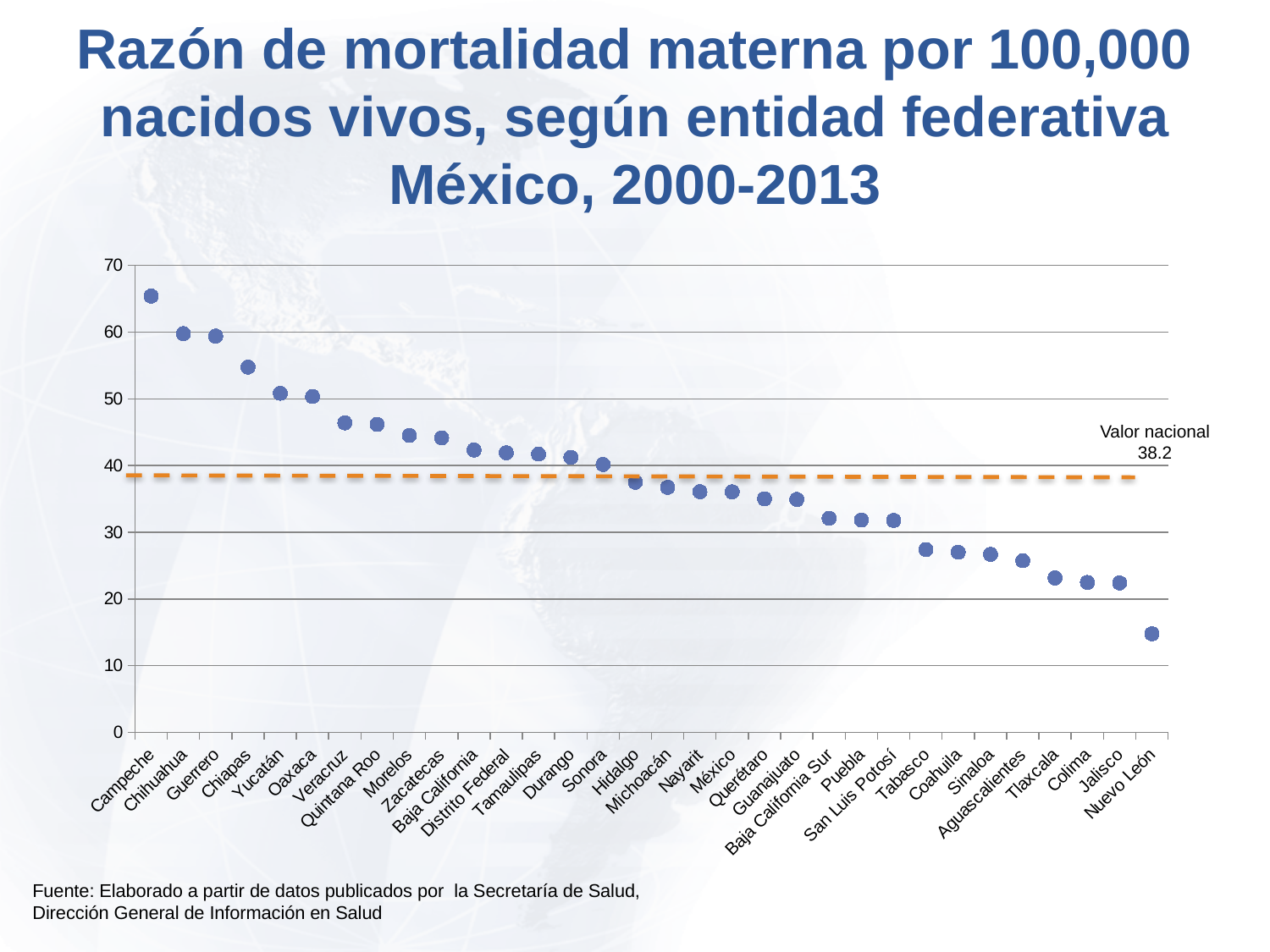
What kind of chart is shown on the slide? Scatter (dot) chart What is the national value (Valor nacional) shown by the dashed line? 38.2 Is the value for Chiapas greater or less than 50? greater Is the value for Nuevo León greater or less than 20? less Which entity has the highest maternal mortality ratio on the chart? Campeche How many entities (categories) are plotted on the chart? 32 Is the value for Tabasco greater or less than 30? less Which entity has the lowest maternal mortality ratio on the chart? Nuevo León Which has a lower maternal mortality ratio, Jalisco or Puebla? Jalisco Do the plotted values rise or fall from left to right along the x axis? fall Which has a higher maternal mortality ratio, Guerrero or Hidalgo? Guerrero